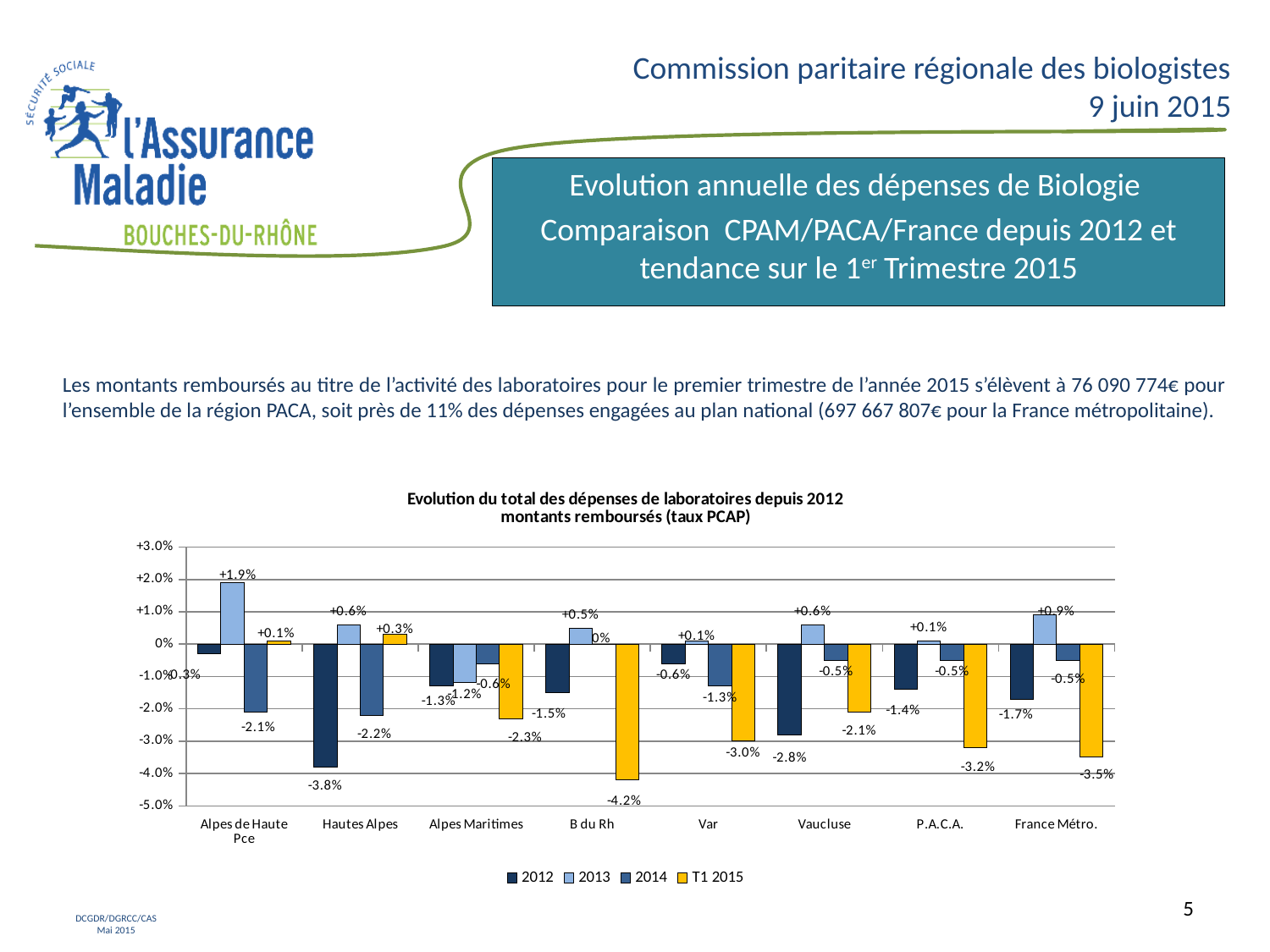
Which category has the lowest value in the T1 2015 series? B du Rh What is the title of the chart? Evolution du total des dépenses de laboratoires depuis 2012 montants remboursés (taux PCAP) What is the difference between the T1 2015 values for P.A.C.A. and France Métro.? 0.3% What type of chart is shown on the slide? bar chart What is the value for B du Rh in the T1 2015 series? -4.2% How many categories are shown on the x axis of the chart? 8 What is the value for Hautes Alpes in the 2012 series? -3.8% What is the value for Alpes de Haute Pce in the 2013 series? +1.9% What is the value for France Métro. in the T1 2015 series? -3.5% Which is larger, the 2012 value for Vaucluse or the 2012 value for Var? Var How many series does the chart legend list? 4 Which category has the highest value in the 2013 series? Alpes de Haute Pce